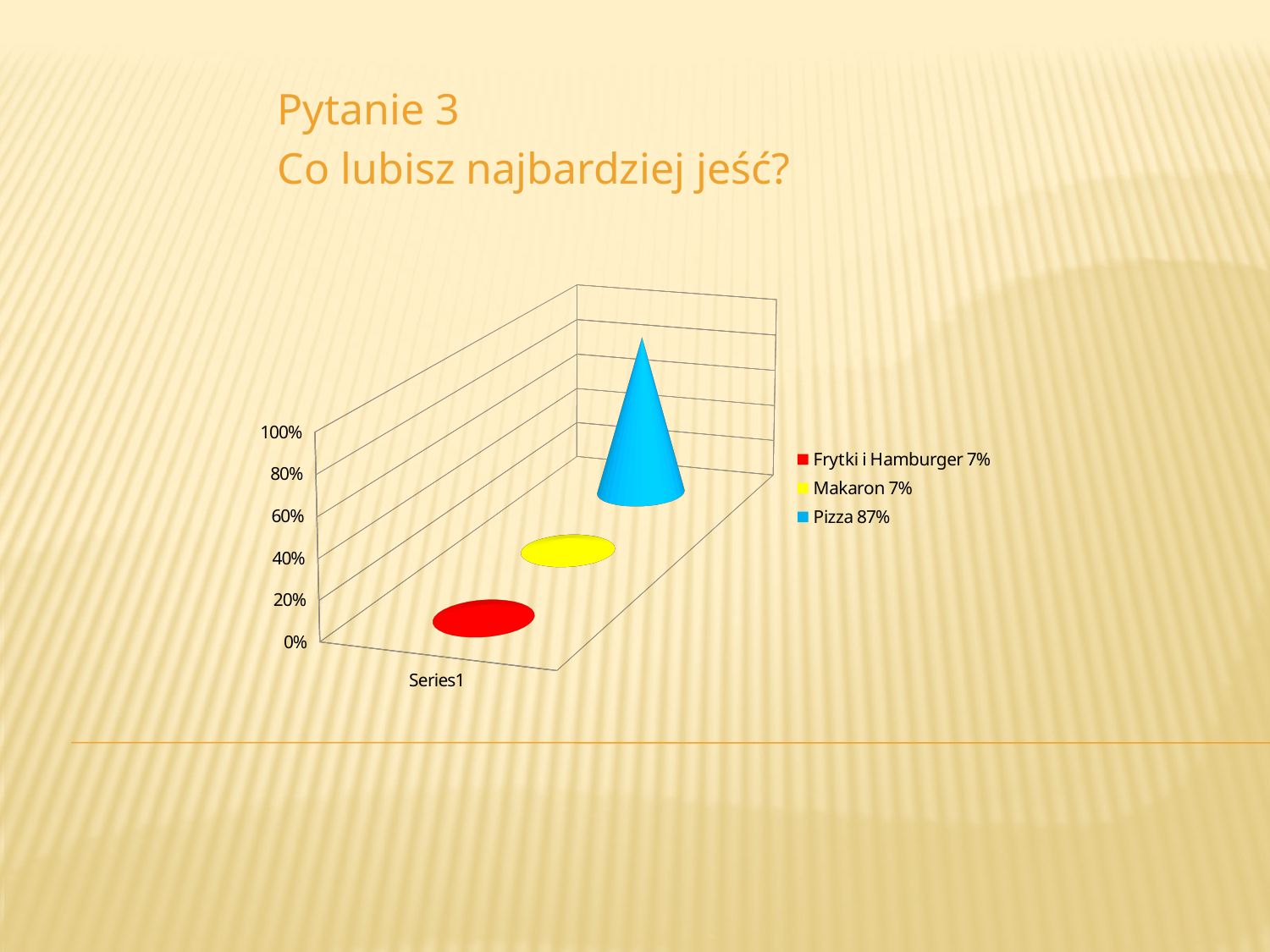
What is the label on the category axis of the chart? Series1 How many series does the legend list? 3 What is the difference between the value for Pizza and the value for Makaron? 80% What colour represents Pizza in the chart? blue What percentage is shown for Makaron? 7% Which is larger, the value for Pizza or the value for Frytki i Hamburger? Pizza What percentage is shown for Frytki i Hamburger? 7% What kind of chart is shown on the slide? bar chart Which food has the highest value? Pizza Is the value for Makaron greater or less than 20%? less Is the value for Pizza greater or less than 80%? greater What percentage is shown for Pizza in the legend? 87%